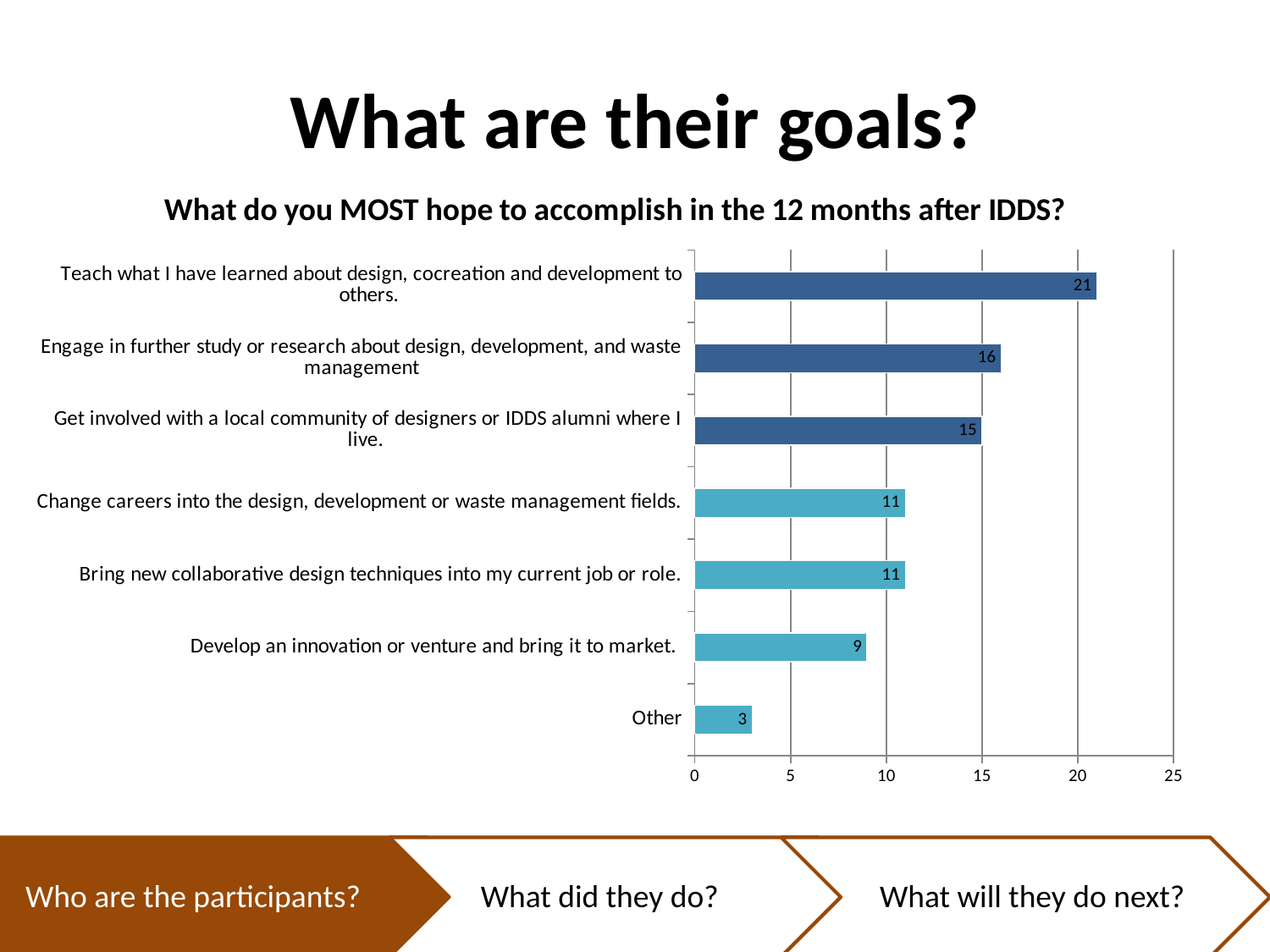
What is the title of the chart? What do you MOST hope to accomplish in the 12 months after IDDS? What is the difference between the values for "Teach what I have learned about design, cocreation and development to others." and "Get involved with a local community of designers or IDDS alumni where I live."? 6 What kind of chart is shown on the slide? Bar chart What is the value for "Engage in further study or research about design, development, and waste management"? 16 What is the value for "Teach what I have learned about design, cocreation and development to others."? 21 Is the value for "Get involved with a local community of designers or IDDS alumni where I live." greater or less than 10? greater Which category has the lowest value? Other What is the value for "Develop an innovation or venture and bring it to market."? 9 Which category has the highest value? Teach what I have learned about design, cocreation and development to others. Which is larger: the value for "Engage in further study or research about design, development, and waste management" or the value for "Change careers into the design, development or waste management fields."? Engage in further study or research about design, development, and waste management How many categories are shown in the chart? 7 What is the value for "Other"? 3